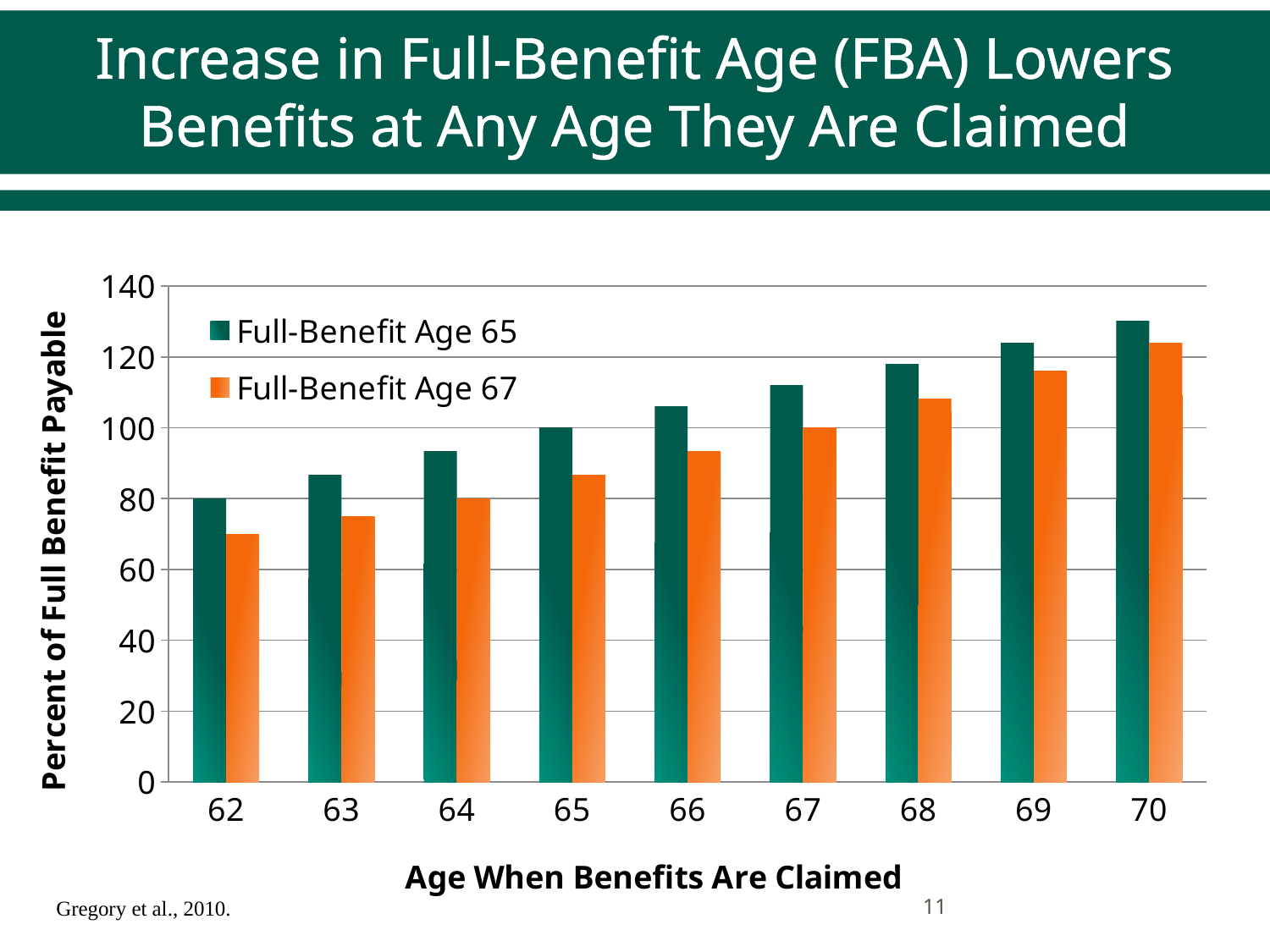
How many series does the legend list? 2 How many claiming ages are shown on the x axis? 9 Which claiming age has the lowest value for Full-Benefit Age 67? 62 What kind of chart is shown on the slide? bar chart What is the value for Full-Benefit Age 65 at claiming age 62? 80 Is the value for Full-Benefit Age 67 at claiming age 62 greater or less than 80? less At claiming age 68, which series has the larger value, Full-Benefit Age 65 or Full-Benefit Age 67? Full-Benefit Age 65 Do the values for Full-Benefit Age 67 rise or fall as the claiming age increases from 62 to 70? rise Is the value for Full-Benefit Age 65 at claiming age 70 greater or less than 120? greater What is the value for Full-Benefit Age 67 at claiming age 67? 100 What is the value for Full-Benefit Age 65 at claiming age 65? 100 Which claiming age has the highest value for Full-Benefit Age 65? 70